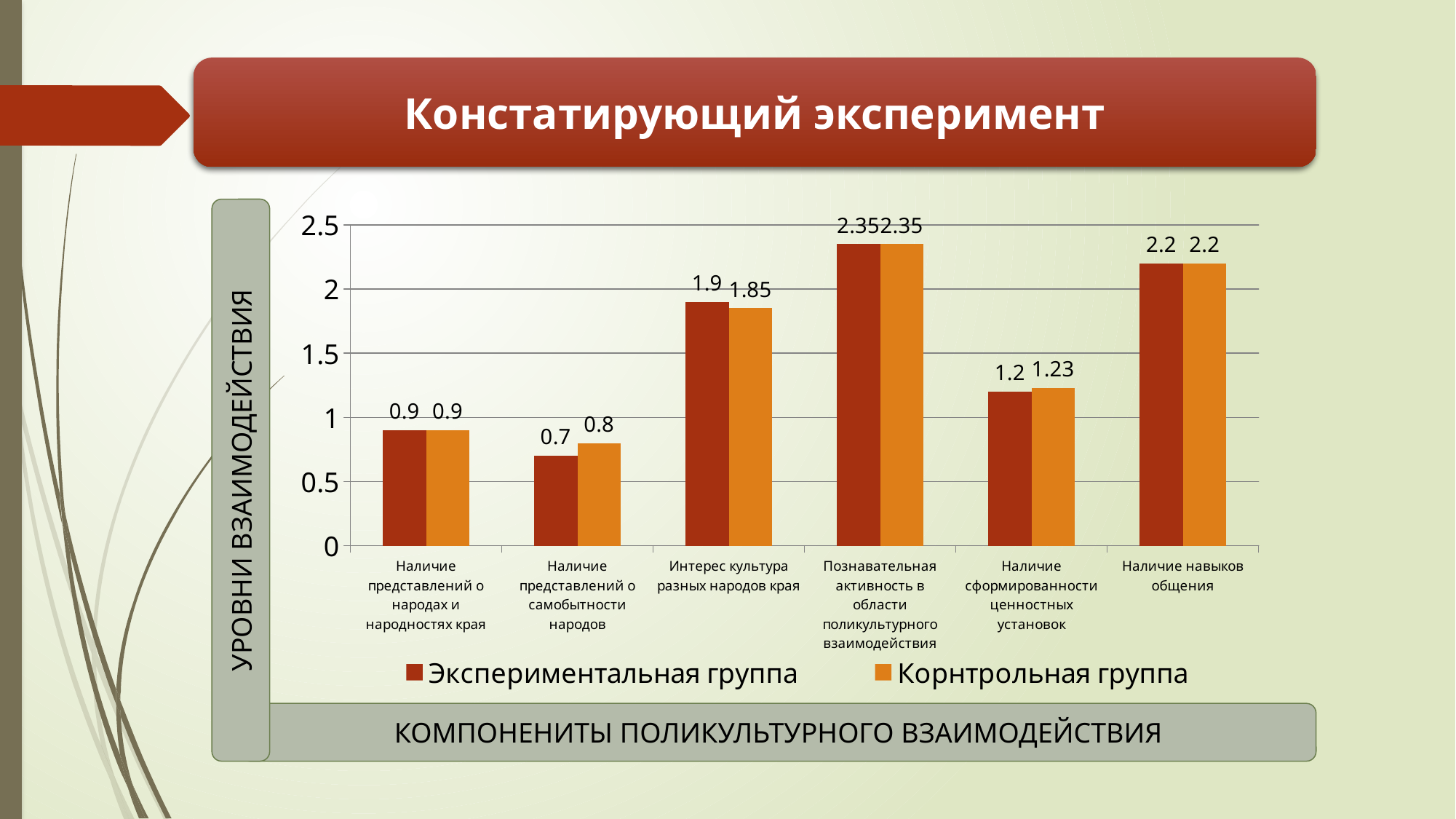
Which category has the highest value for the Экспериментальная группа series? Познавательная активность в области поликультурного взаимодействия How many categories are shown on the x axis of the chart? 6 In the category "Интерес культура разных народов края", which series has the larger value, Экспериментальная группа or Корнтрольная группа? Экспериментальная группа What is the value for the Корнтрольная группа series in the category "Наличие сформированности ценностных установок"? 1.23 What is the title shown above the chart on the slide? Констатирующий эксперимент Is the value for the Экспериментальная группа series in the category "Наличие навыков общения" greater or less than 2? greater How many series does the chart legend list? 2 Which category has the lowest value for the Корнтрольная группа series? Наличие представлений о самобытности народов What kind of chart is shown on the slide? bar chart What is the value for the Корнтрольная группа series in the category "Интерес культура разных народов края"? 1.85 What is the difference between the Экспериментальная группа and Корнтрольная группа values in the category "Наличие представлений о самобытности народов"? 0.1 What is the value for the Экспериментальная группа series in the category "Наличие представлений о самобытности народов"? 0.7